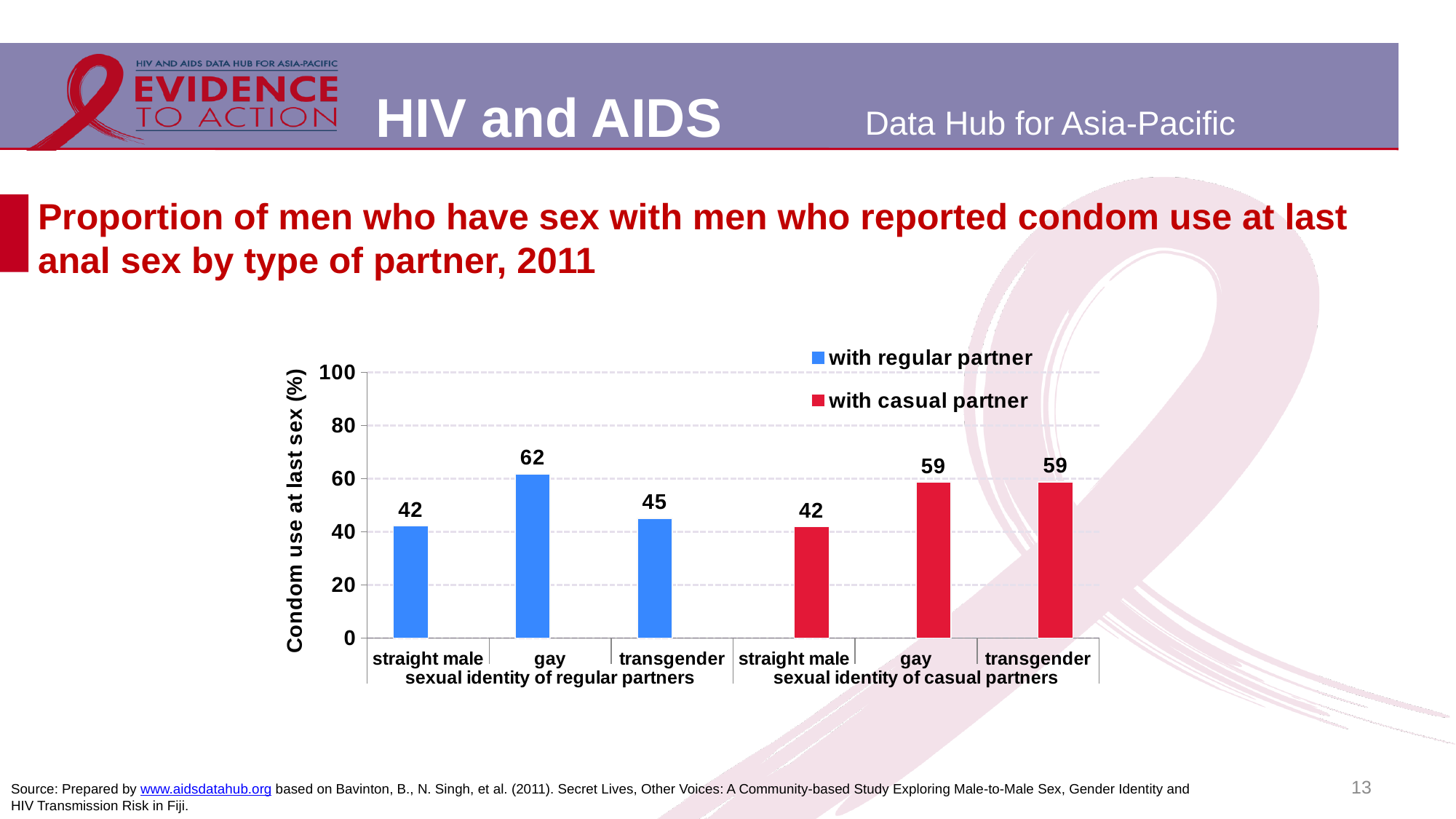
What is the condom use value for gay regular partners? 62 How many bars are plotted in the chart? 6 What is the difference between the values for gay regular partners and transgender regular partners? 17 What kind of chart is shown on the slide? bar chart What is the y-axis label of the chart? Condom use at last sex (%) Which category has the highest condom use value? gay (regular partners) How many series does the legend list? 2 Is the value for gay casual partners greater or less than 40? greater What is the condom use value for straight male regular partners? 42 What is the condom use value for transgender casual partners? 59 Which is larger: the value for transgender regular partners or transgender casual partners? transgender casual partners What colour are the bars for 'with casual partner'? red